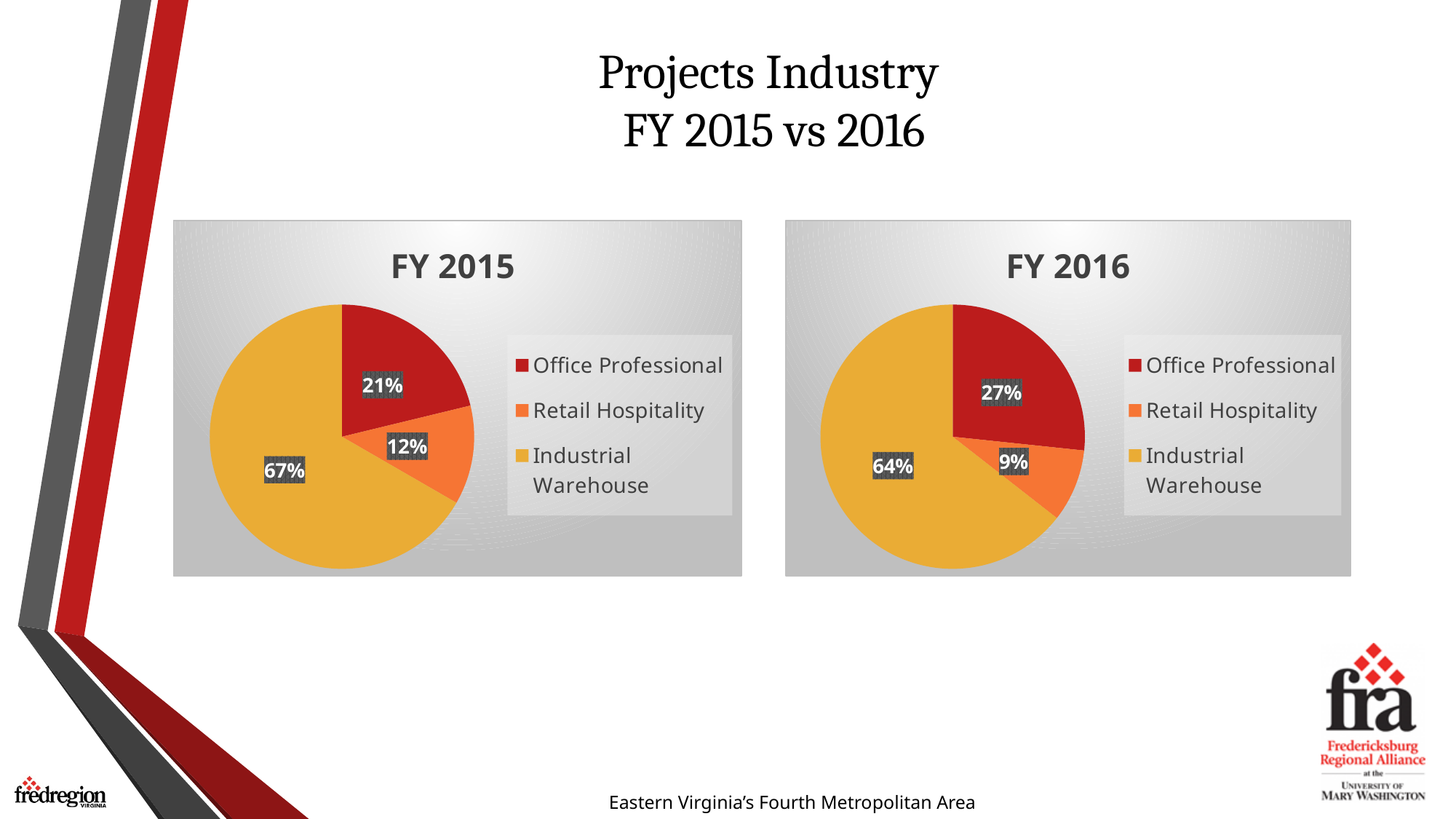
What type of chart is the FY 2016 chart? Pie chart How many slices does the FY 2015 chart have? 3 In the FY 2015 chart, what share does Office Professional have? 21% In the FY 2016 chart, what share does Industrial Warehouse have? 64% In the FY 2015 chart, which category has the largest slice? Industrial Warehouse In the FY 2015 chart, what colour is the Industrial Warehouse slice? Yellow/gold In the FY 2016 chart, what is the difference between the Office Professional and Retail Hospitality shares? 18% In the FY 2015 chart, what share does Retail Hospitality have? 12% How many entries does the legend of the FY 2016 chart list? 3 In the FY 2015 chart, which is larger, Office Professional or Retail Hospitality? Office Professional In the FY 2016 chart, what share does Retail Hospitality have? 9% In the FY 2016 chart, which category has the smallest slice? Retail Hospitality